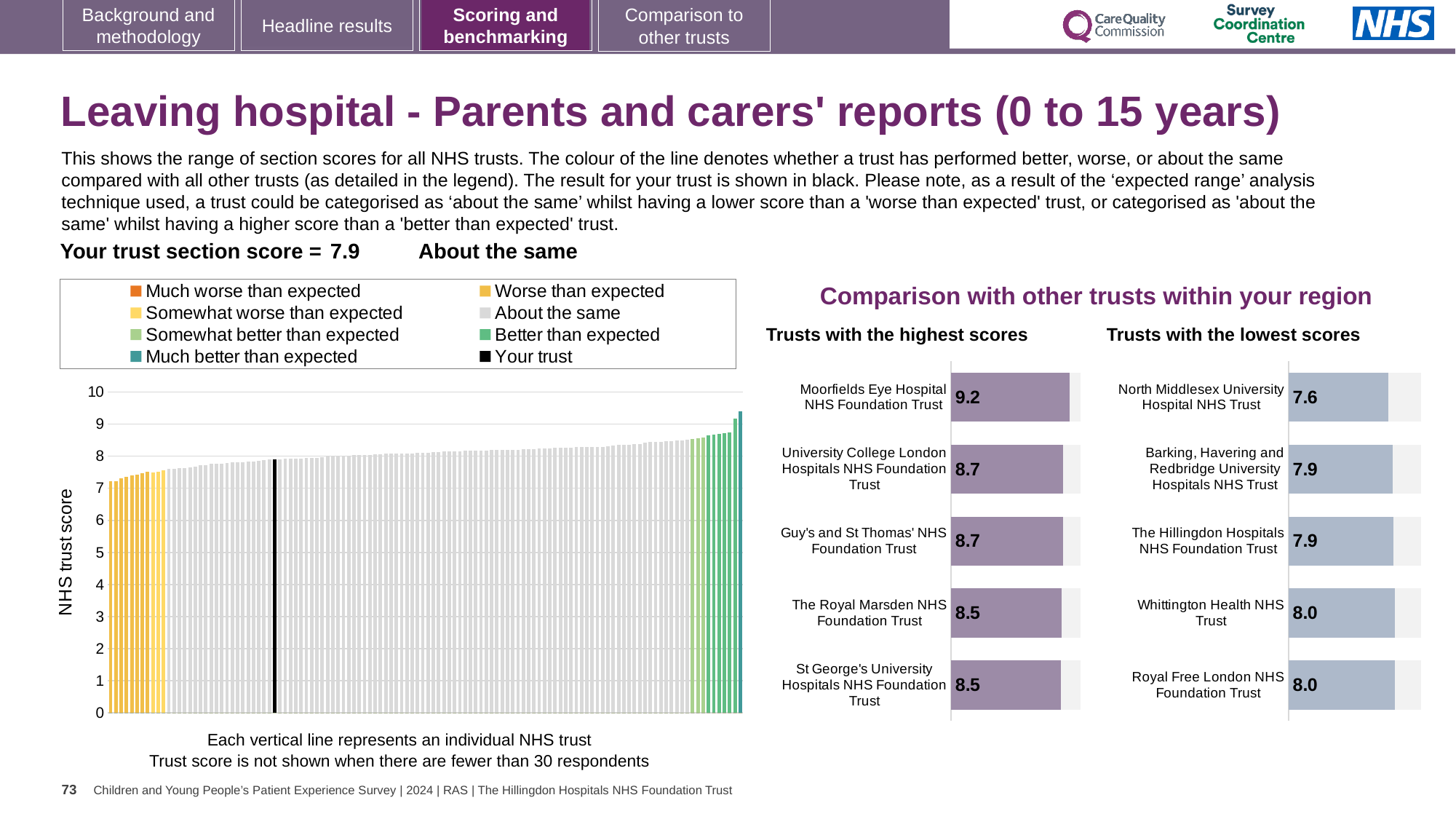
In the 'Trusts with the lowest scores' chart, which trust has the lowest score? North Middlesex University Hospital NHS Trust Which is larger: the score for Moorfields Eye Hospital NHS Foundation Trust in the highest scores chart, or the score for North Middlesex University Hospital NHS Trust in the lowest scores chart? Moorfields Eye Hospital NHS Foundation Trust In the 'Trusts with the highest scores' chart, what is the score for Moorfields Eye Hospital NHS Foundation Trust? 9.2 In the 'Trusts with the highest scores' chart, what is the score for The Royal Marsden NHS Foundation Trust? 8.5 How many trusts are shown in the 'Trusts with the highest scores' chart? 5 In the 'Trusts with the lowest scores' chart, what is the score for Whittington Health NHS Trust? 8.0 In the large chart on the left, do the trust scores rise or fall from left to right along the x axis? Rise In the 'Trusts with the highest scores' chart, which trust has the highest score? Moorfields Eye Hospital NHS Foundation Trust In the 'Trusts with the lowest scores' chart, what is the score for North Middlesex University Hospital NHS Trust? 7.6 What kind of chart is the large chart on the left with the 'NHS trust score' axis? Bar chart In the 'Trusts with the lowest scores' chart, what is the difference between the scores of Royal Free London NHS Foundation Trust and North Middlesex University Hospital NHS Trust? 0.4 In the 'Trusts with the highest scores' chart, what is the difference between the scores of Moorfields Eye Hospital NHS Foundation Trust and St George's University Hospitals NHS Foundation Trust? 0.7